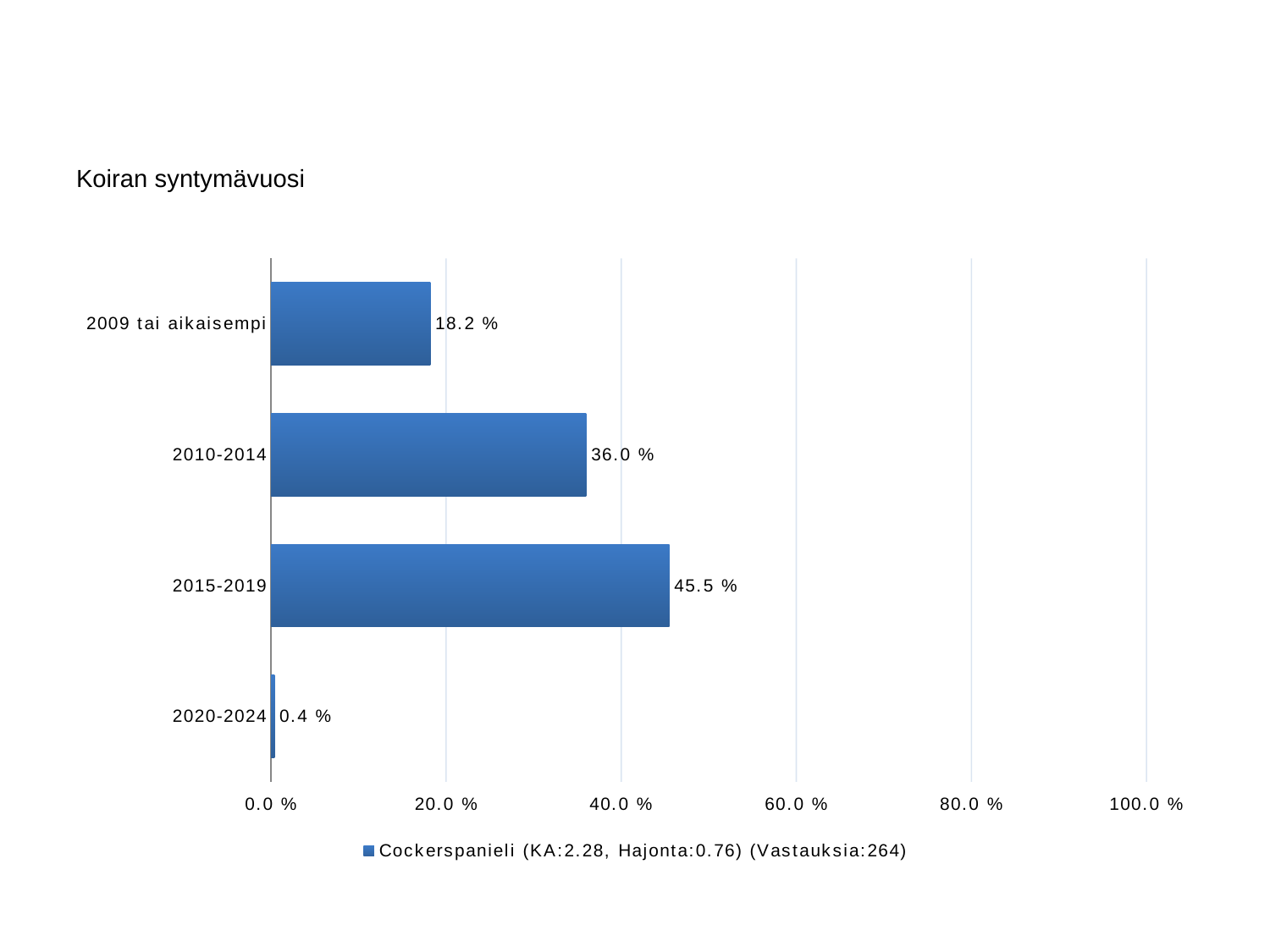
What is the difference between the values for 2015-2019 and 2010-2014? 9.5 % What is the value for 2020-2024? 0.4 % What kind of chart is shown on the slide? bar chart Which category has the highest value? 2015-2019 Which category has the lowest value? 2020-2024 How many categories are shown on the chart? 4 What is the value for 2015-2019? 45.5 % How many series does the legend list? 1 Which is larger, the value for 2010-2014 or the value for 2009 tai aikaisempi? 2010-2014 What is the value for 2009 tai aikaisempi? 18.2 % Is the value for 2010-2014 greater or less than 40.0 %? less What is the title of the chart? Koiran syntymävuosi